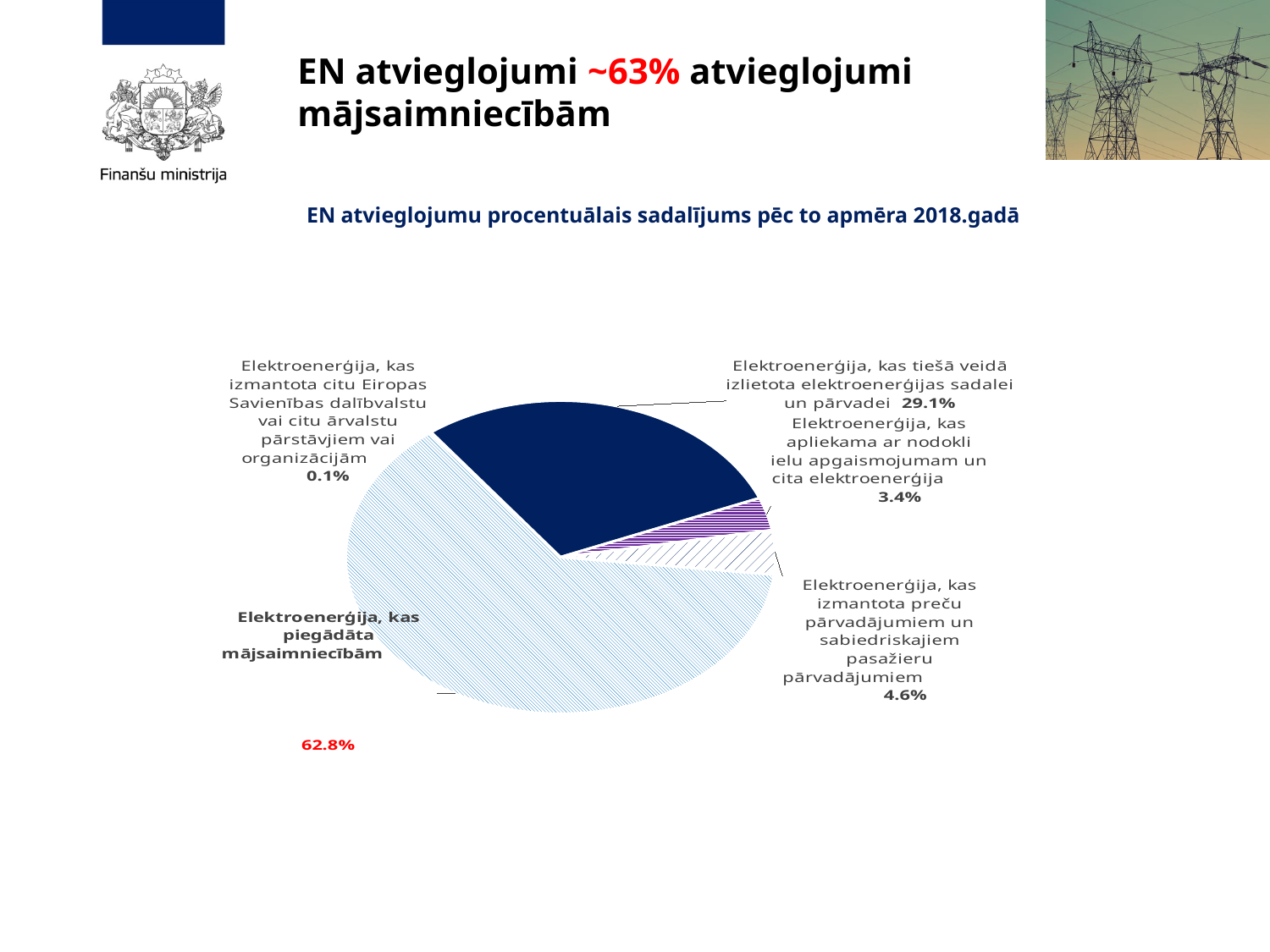
What is the difference in percentage points between the share for households (mājsaimniecībām) and the share for distribution and transmission (sadalei un pārvadei)? 33.7 What share of the pie is 'Elektroenerģija, kas apliekama ar nodokli ielu apgaismojumam un cita elektroenerģija'? 3.4% Which category has the largest share of the pie? Elektroenerģija, kas piegādāta mājsaimniecībām What share of the pie is 'Elektroenerģija, kas izmantota preču pārvadājumiem un sabiedriskajiem pasažieru pārvadājumiem'? 4.6% What is the title of the chart? EN atvieglojumu procentuālais sadalījums pēc to apmēra 2018.gadā What share of the pie is 'Elektroenerģija, kas tiešā veidā izlietota elektroenerģijas sadalei un pārvadei'? 29.1% What share of the pie is 'Elektroenerģija, kas piegādāta mājsaimniecībām'? 62.8% Which is larger: the share for freight and public passenger transport (preču pārvadājumiem) or the share for street lighting and other electricity (ielu apgaismojumam)? preču pārvadājumiem (4.6%) How many slices does the pie chart have? 5 Which category has the smallest share of the pie? Elektroenerģija, kas izmantota citu Eiropas Savienības dalībvalstu vai citu ārvalstu pārstāvjiem vai organizācijām What share of the pie is 'Elektroenerģija, kas izmantota citu Eiropas Savienības dalībvalstu vai citu ārvalstu pārstāvjiem vai organizācijām'? 0.1% What kind of chart is shown on the slide? pie chart